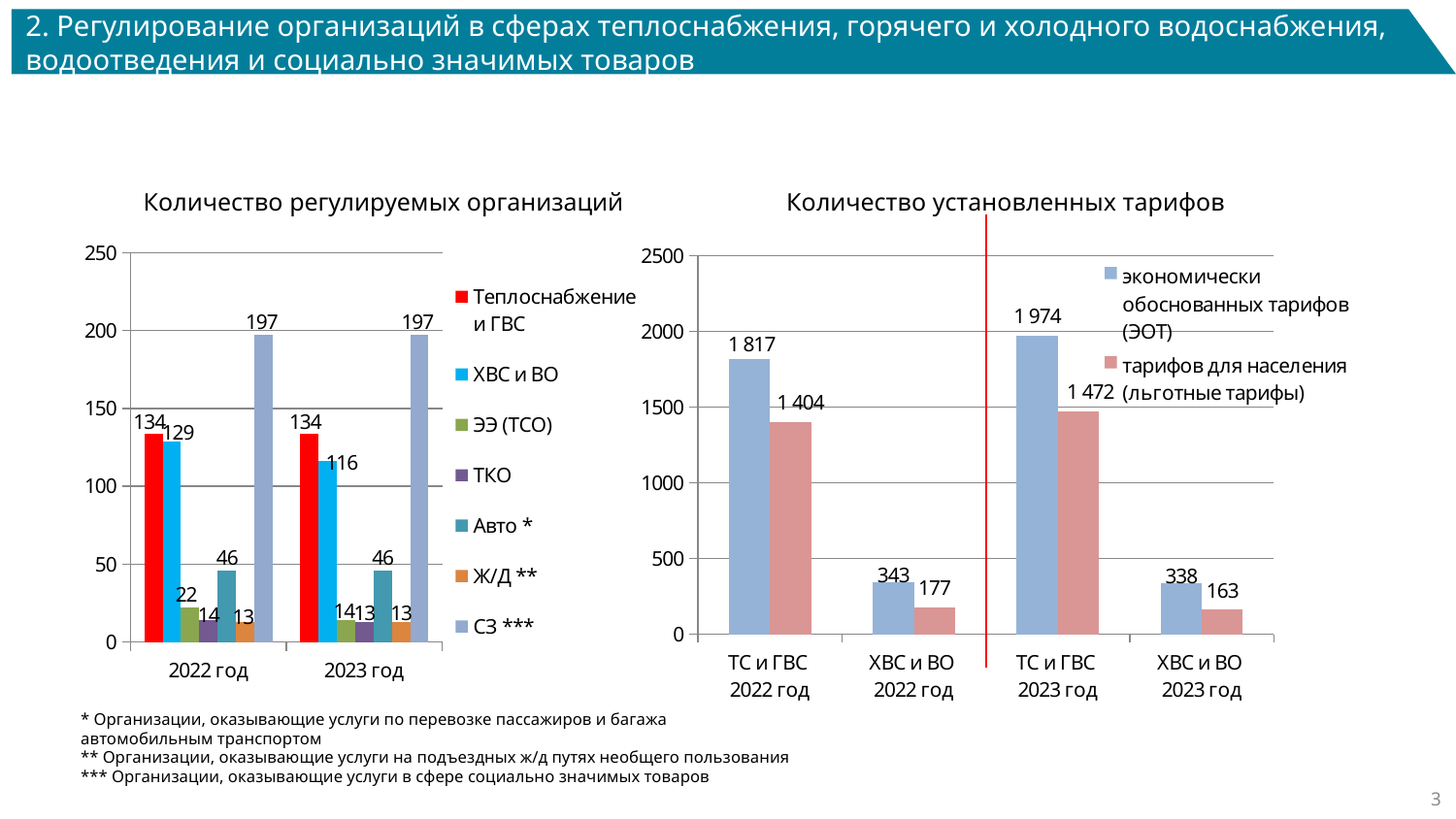
On the chart 'Количество регулируемых организаций', what is the difference between the ХВС и ВО values for 2022 год and 2023 год? 13 On the chart 'Количество регулируемых организаций', how many series does the legend list? 7 On the chart 'Количество установленных тарифов', which category has the highest ЭОТ value? ТС и ГВС 2023 год On the chart 'Количество установленных тарифов', how many categories are shown on the x axis? 4 What kind of chart is 'Количество регулируемых организаций'? bar chart On the chart 'Количество установленных тарифов', what is the value of экономически обоснованных тарифов (ЭОТ) for ТС и ГВС 2023 год? 1 974 On the chart 'Количество установленных тарифов', what is the value of тарифов для населения (льготные тарифы) for ХВС и ВО 2022 год? 177 On the chart 'Количество регулируемых организаций', what is the value for ХВС и ВО in 2023 год? 116 On the chart 'Количество регулируемых организаций', what is the value for ЭЭ (ТСО) in 2022 год? 22 On the chart 'Количество установленных тарифов', how many series does the legend list? 2 On the chart 'Количество регулируемых организаций', which series has the highest value in 2022 год? СЗ *** On the chart 'Количество установленных тарифов', by how much did the ЭОТ value for ТС и ГВС increase from 2022 год to 2023 год? 157